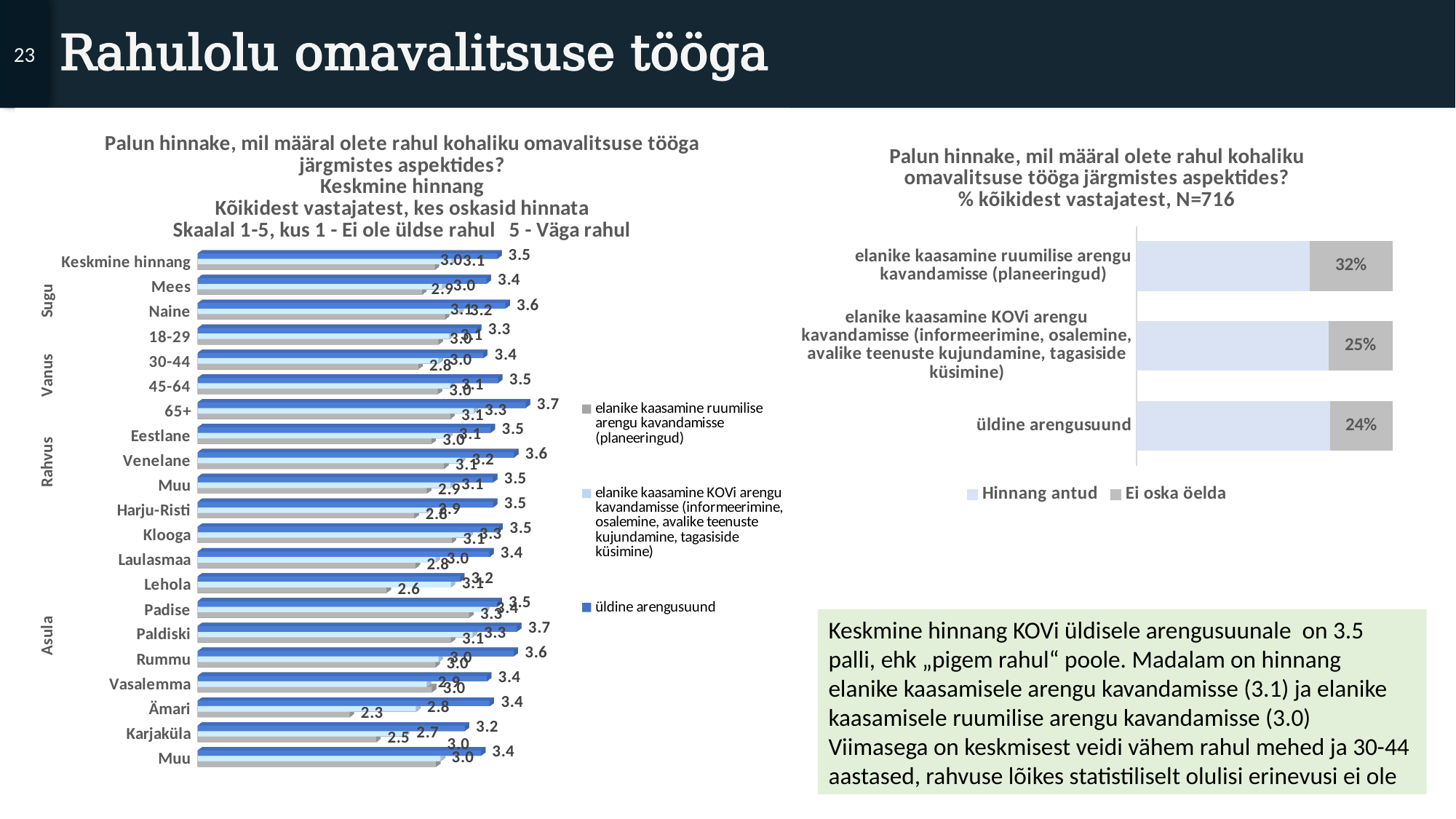
In the chart on the right, how many series does the legend list? 2 In the chart on the left, what is the 'üldine arengusuund' value for 'Karjaküla'? 3.2 In the chart on the left, which has the higher 'üldine arengusuund' value, 'Mees' or 'Naine'? Naine In the chart on the left, how many series does the legend list? 3 In the chart on the right, what is the 'Ei oska öelda' share for 'üldine arengusuund'? 24% What kind of chart is the chart on the right of the slide? bar chart In the chart on the left, what is the 'üldine arengusuund' value for '65+'? 3.7 In the chart on the right, what is the 'Ei oska öelda' share for 'elanike kaasamine ruumilise arengu kavandamisse (planeeringud)'? 32% In the chart on the right, which category has the highest 'Ei oska öelda' share? elanike kaasamine ruumilise arengu kavandamisse (planeeringud) In the chart on the left, what is the 'elanike kaasamine ruumilise arengu kavandamisse (planeeringud)' value for 'Ämari'? 2.3 In the chart on the right, what is the difference between the 'Ei oska öelda' share for 'elanike kaasamine ruumilise arengu kavandamisse (planeeringud)' and for 'üldine arengusuund'? 8 percentage points In the chart on the right, how many categories are shown? 3